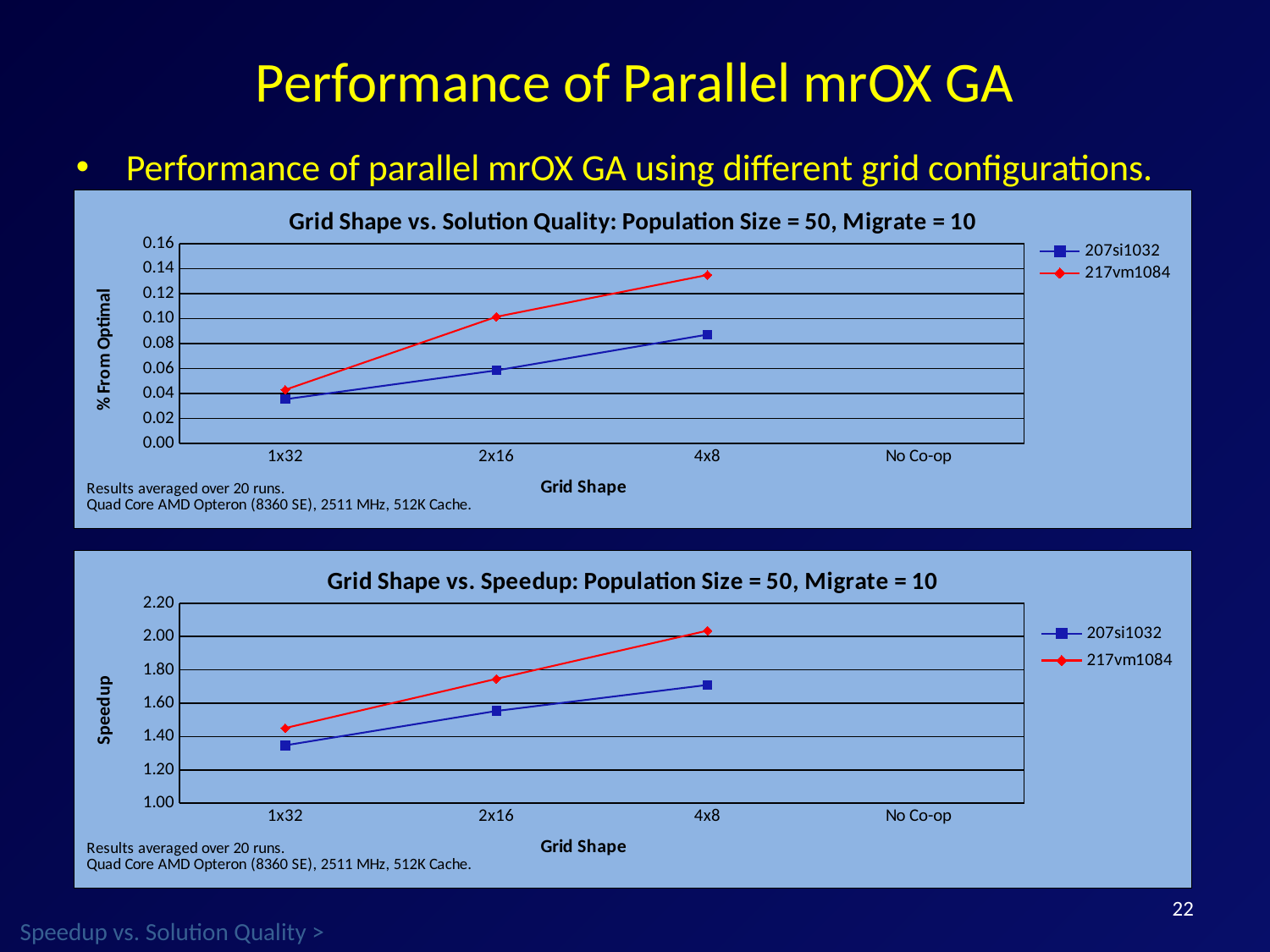
In the top chart, 'Grid Shape vs. Solution Quality', is the value for 217vm1084 at 4x8 greater or less than 0.12? greater In the bottom chart, 'Grid Shape vs. Speedup', do the speedup values for 217vm1084 rise or fall from 1x32 to 4x8? rise In the bottom chart, 'Grid Shape vs. Speedup', is the value for 217vm1084 at 4x8 greater or less than 1.80? greater In the top chart, 'Grid Shape vs. Solution Quality', is the value for 207si1032 at 4x8 greater or less than 0.10? less How many grid shape categories are labelled on the x axis of the top chart, 'Grid Shape vs. Solution Quality'? 4 What kind of chart is the top chart, 'Grid Shape vs. Solution Quality'? line chart In the top chart, 'Grid Shape vs. Solution Quality', at which grid shape does 217vm1084 reach its highest % from optimal? 4x8 In the bottom chart, 'Grid Shape vs. Speedup', which series has the lower speedup at 2x16? 207si1032 In the top chart, 'Grid Shape vs. Solution Quality', which series has the higher value at 4x8? 217vm1084 How many series does the legend of the bottom chart, 'Grid Shape vs. Speedup', list? 2